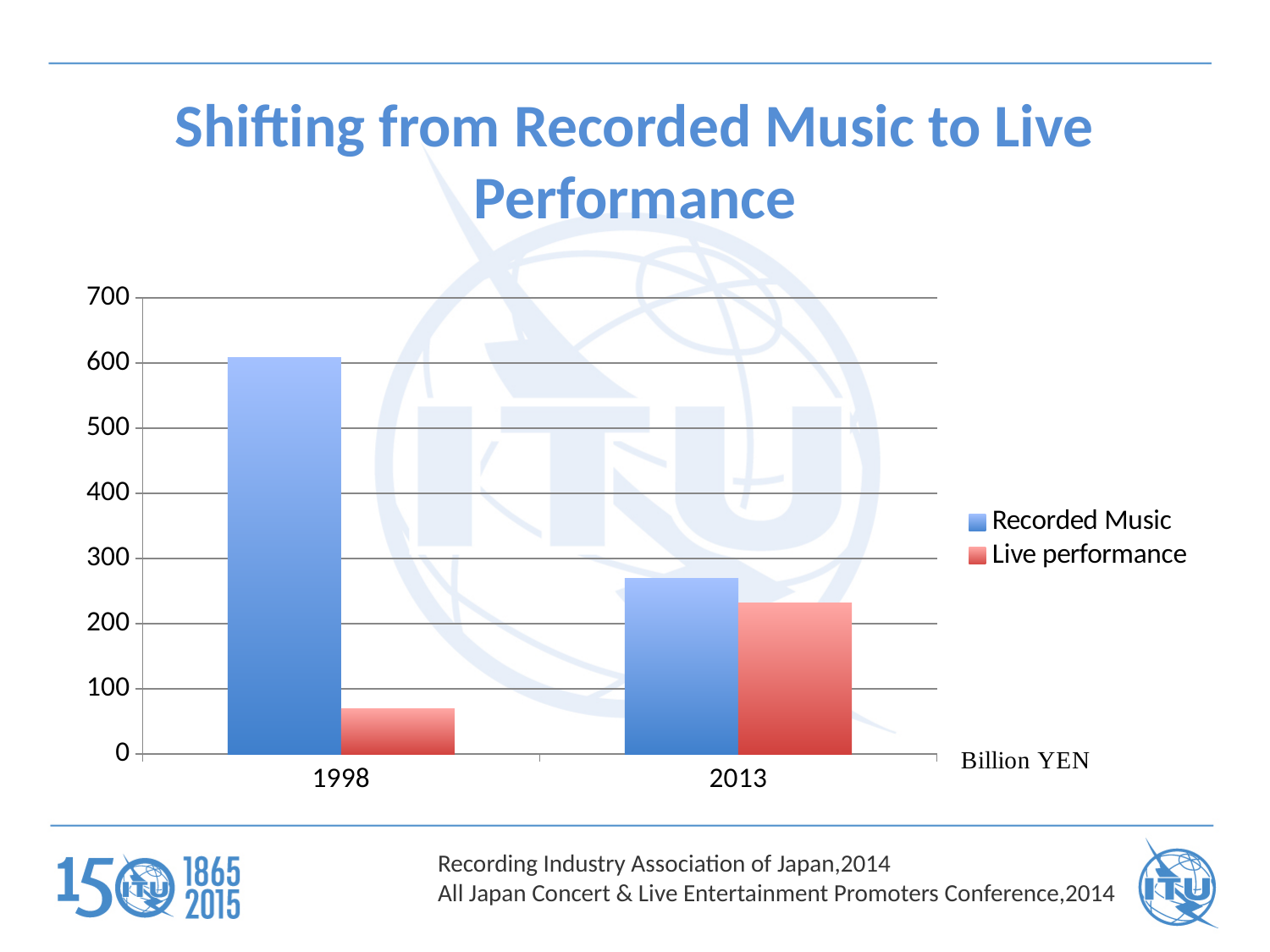
Does the value for Recorded Music rise or fall from 1998 to 2013? fall How many categories are shown on the x axis? 2 Is the value for Live performance in 1998 greater or less than 100? less Is the value for Live performance in 2013 greater or less than 200? greater Is the value for Recorded Music in 2013 greater or less than 300? less Which year has the higher value for Live performance, 1998 or 2013? 2013 What kind of chart is shown on the slide? Bar chart Does the value for Live performance rise or fall from 1998 to 2013? rise Which year has the higher value for Recorded Music, 1998 or 2013? 1998 What unit is indicated for the values on the chart? Billion YEN How many series does the legend list? 2